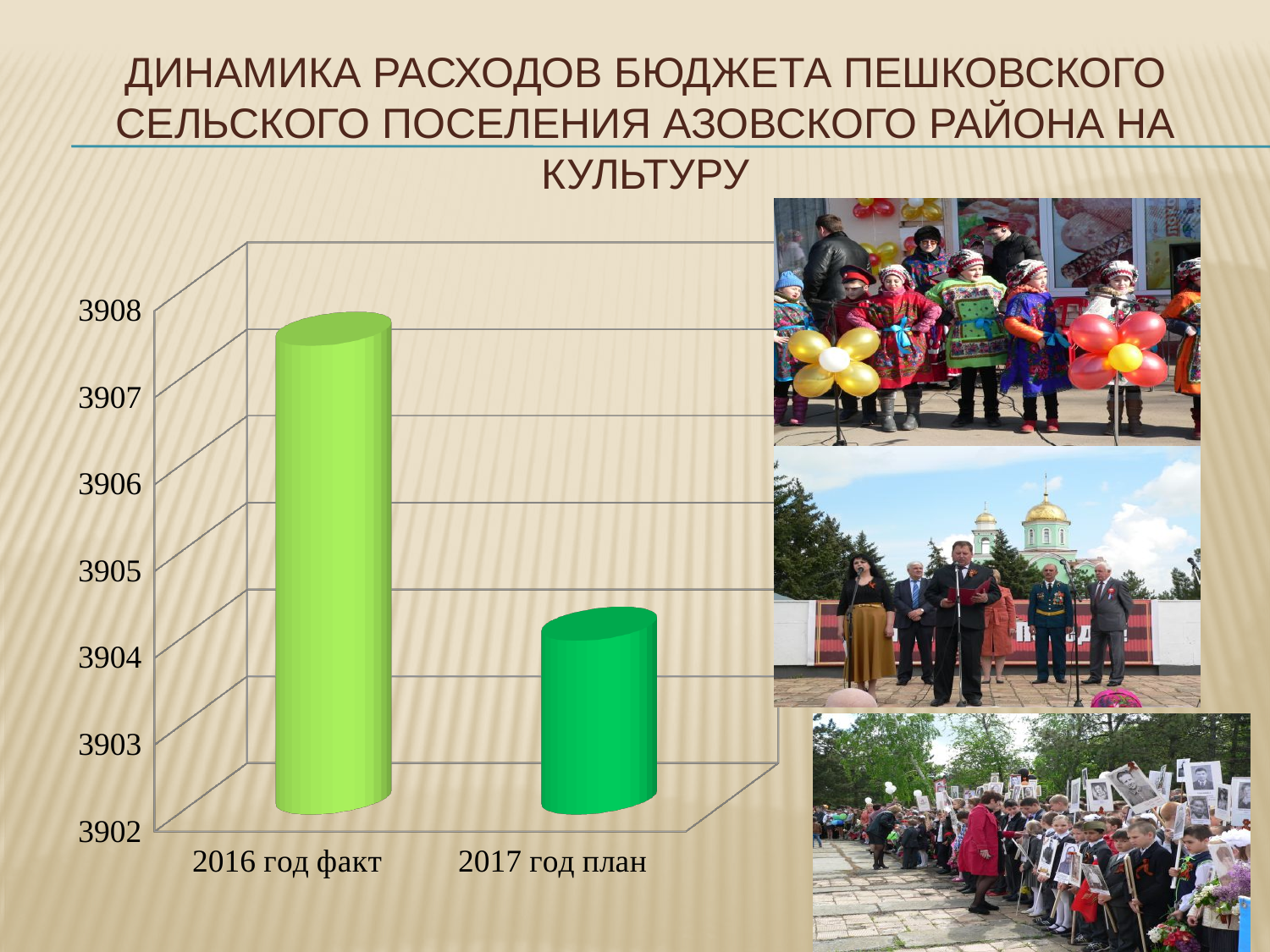
What is the lowest value shown on the vertical axis of the chart? 3902 How many categories are shown on the x axis of the chart? 2 Which is larger, the value for 2016 год факт or the value for 2017 год план? 2016 год факт Is the value for 2017 год план greater or less than 3905? less What is the highest value shown on the vertical axis of the chart? 3908 Which category has the lowest value in the chart? 2017 год план Do the values rise or fall from 2016 год факт to 2017 год план? fall Which category has the highest value in the chart? 2016 год факт What kind of chart is shown on the slide? bar chart Is the value for 2016 год факт greater or less than 3907? greater